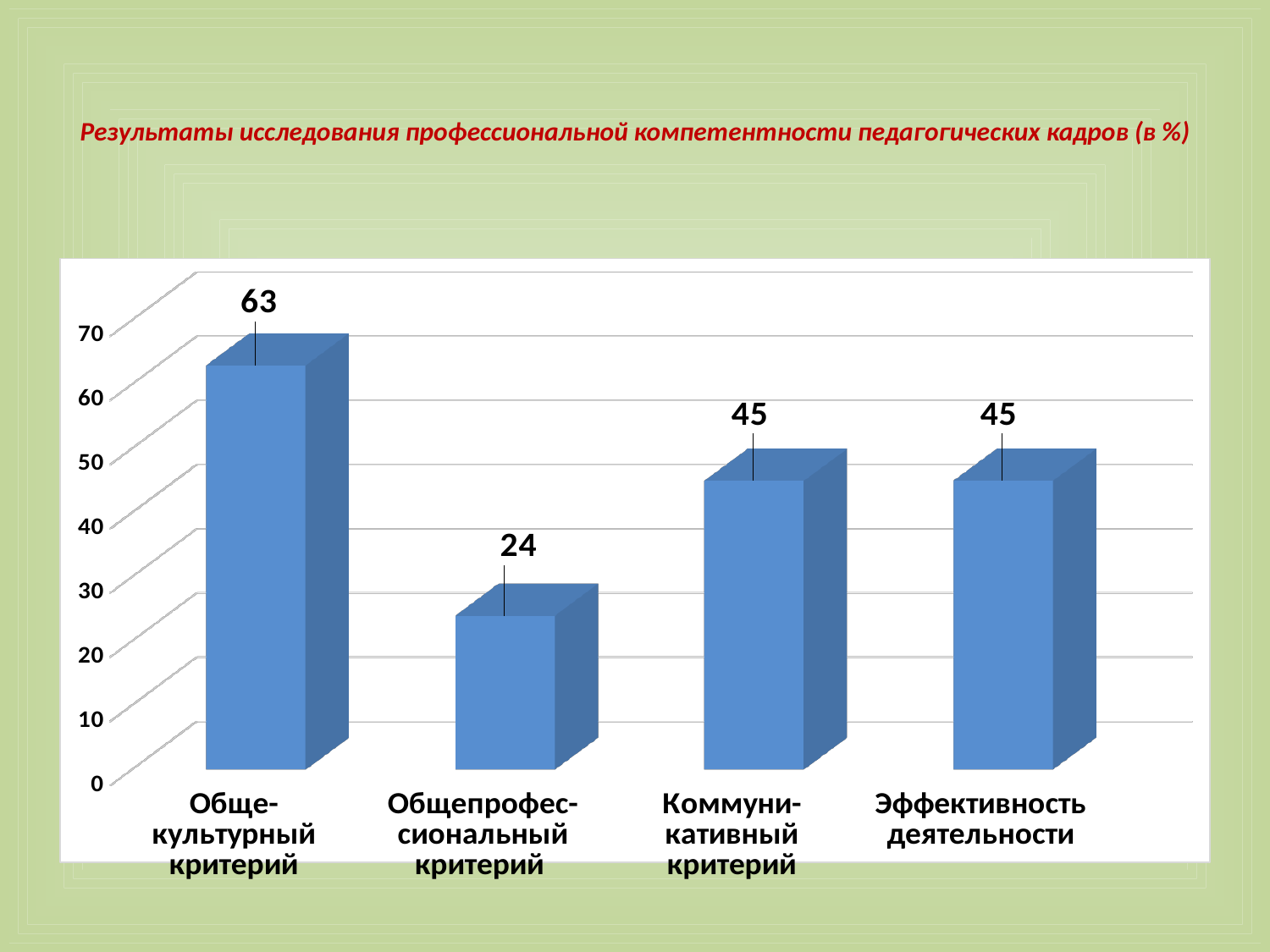
What is the title of the slide? Результаты исследования профессиональной компетентности педагогических кадров (в %) What kind of chart is shown on the slide? Bar chart What is the value for Коммуникативный критерий? 45 Which is larger, the value for Общепрофессиональный критерий or the value for Эффективность деятельности? Эффективность деятельности What is the value for Общепрофессиональный критерий? 24 What is the difference between the values for Общекультурный критерий and Коммуникативный критерий? 18 Which category has the highest value? Общекультурный критерий What is the difference between the values for Общекультурный критерий and Общепрофессиональный критерий? 39 What is the value for Эффективность деятельности? 45 What is the value for Общекультурный критерий? 63 Which category has the lowest value? Общепрофессиональный критерий How many categories are shown in the chart? 4